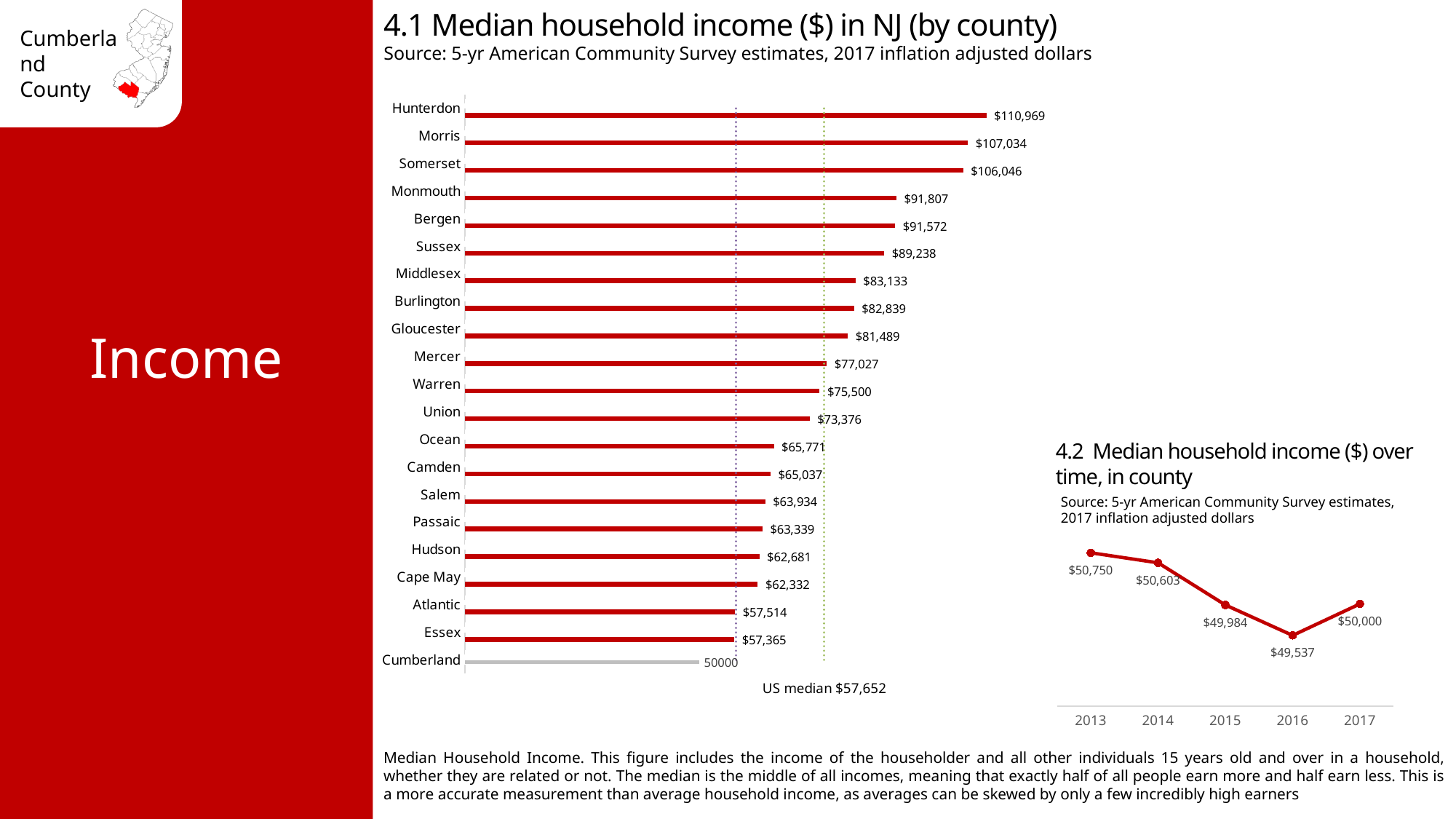
In chart 4.1 (Median household income in NJ by county), what is the difference between Hunterdon's and Morris's median household income? $3,935 In chart 4.1 (Median household income in NJ by county), which county has the lowest median household income? Cumberland In chart 4.2 (Median household income over time, in county), what is the value for 2013? $50,750 In chart 4.1 (Median household income in NJ by county), which county has the highest median household income? Hunterdon In chart 4.1 (Median household income in NJ by county), how many counties are shown? 21 In chart 4.2 (Median household income over time, in county), what is the difference between the 2013 and 2017 values? $750 In chart 4.1 (Median household income in NJ by county), which has a higher median household income, Ocean or Union? Union In chart 4.1 (Median household income in NJ by county), what US median value is marked by the reference line? $57,652 What kind of chart is chart 4.1 (Median household income in NJ by county)? Bar chart In chart 4.1 (Median household income in NJ by county), what is the median household income for Gloucester? $81,489 In chart 4.2 (Median household income over time, in county), which year has the lowest value? 2016 In chart 4.2 (Median household income over time, in county), how does the value change from 2013 to 2016? It falls